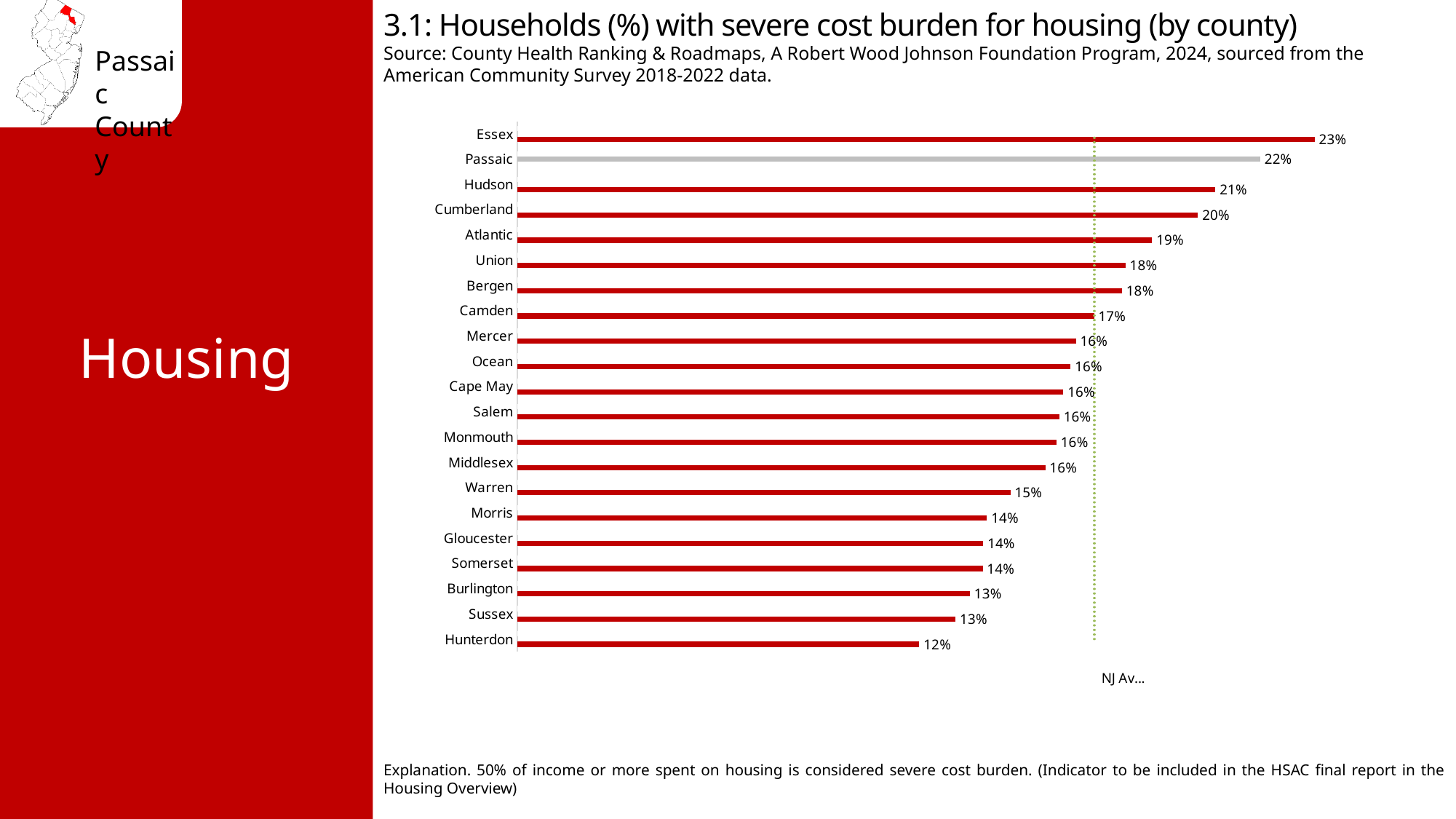
Which has a higher value, Cumberland or Atlantic? Cumberland What value is shown for Hudson County? 21% What type of chart is shown on the slide? Bar chart Which county has the highest percentage of households with severe housing cost burden? Essex What is the difference in percentage points between Passaic and Hudson? 1 percentage point Do the values rise or fall going from the top of the chart to the bottom? Fall What is the difference in percentage points between Essex and Hunterdon? 11 percentage points What is the percentage of households with severe cost burden for housing in Passaic County? 22% Which county's bar is coloured grey instead of red? Passaic What value is shown for Warren County? 15% Which county has the lowest percentage of households with severe housing cost burden? Hunterdon How many counties are listed in the chart? 21